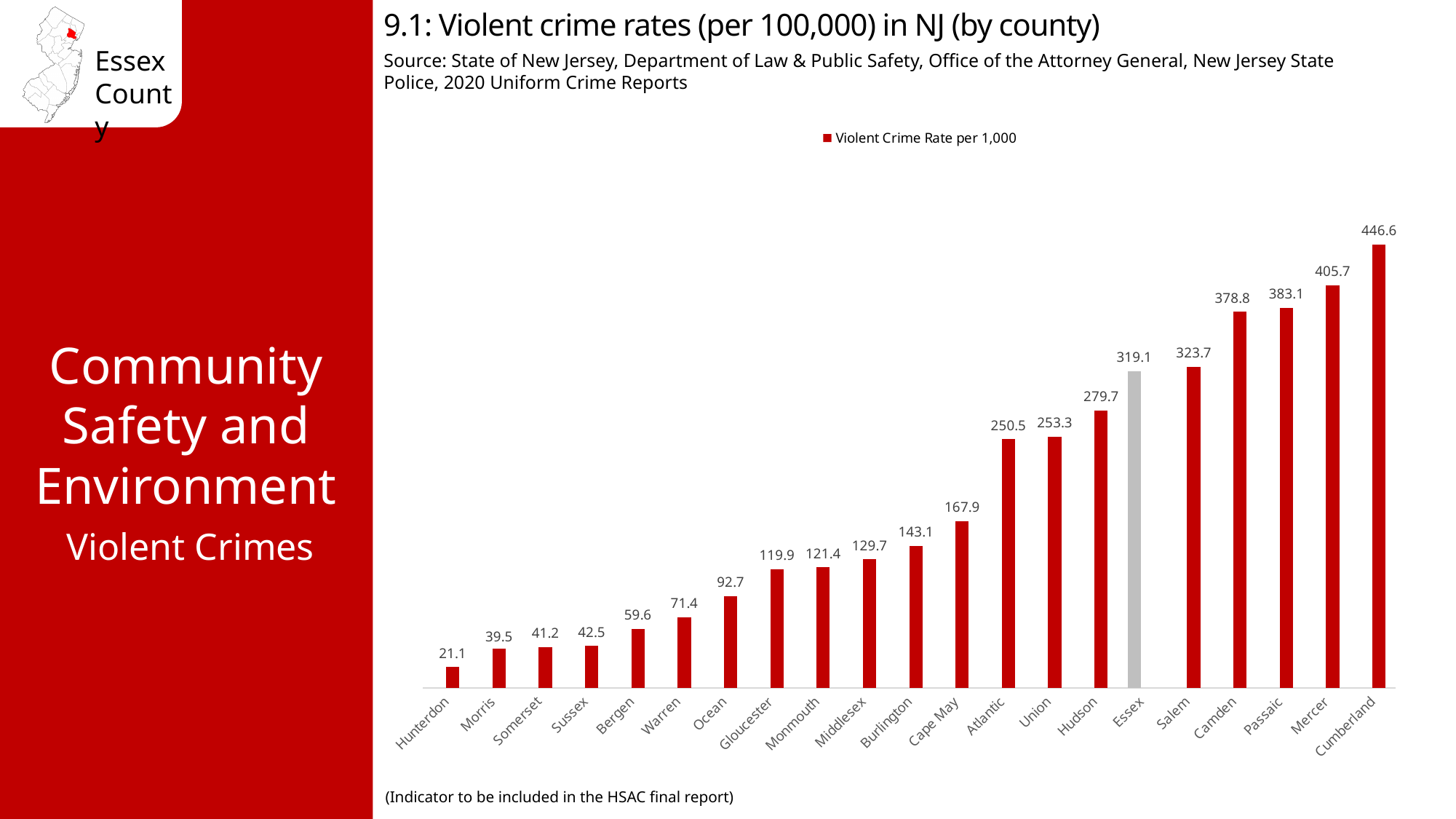
What is the difference between the violent crime rates of Cumberland and Essex? 127.5 Which county has the lowest violent crime rate on the chart? Hunterdon What type of chart is shown on the slide? Bar chart What is the violent crime rate shown for Cape May? 167.9 How many counties are shown on the chart? 21 Do the values rise or fall moving from left to right along the x axis? Rise What is the difference between the violent crime rates of Essex and Hunterdon? 298.0 What is the violent crime rate shown for Essex County? 319.1 Which county has the highest violent crime rate on the chart? Cumberland What is the violent crime rate shown for Hudson County? 279.7 How many series does the legend list? 1 Which county has a higher violent crime rate, Camden or Salem? Camden